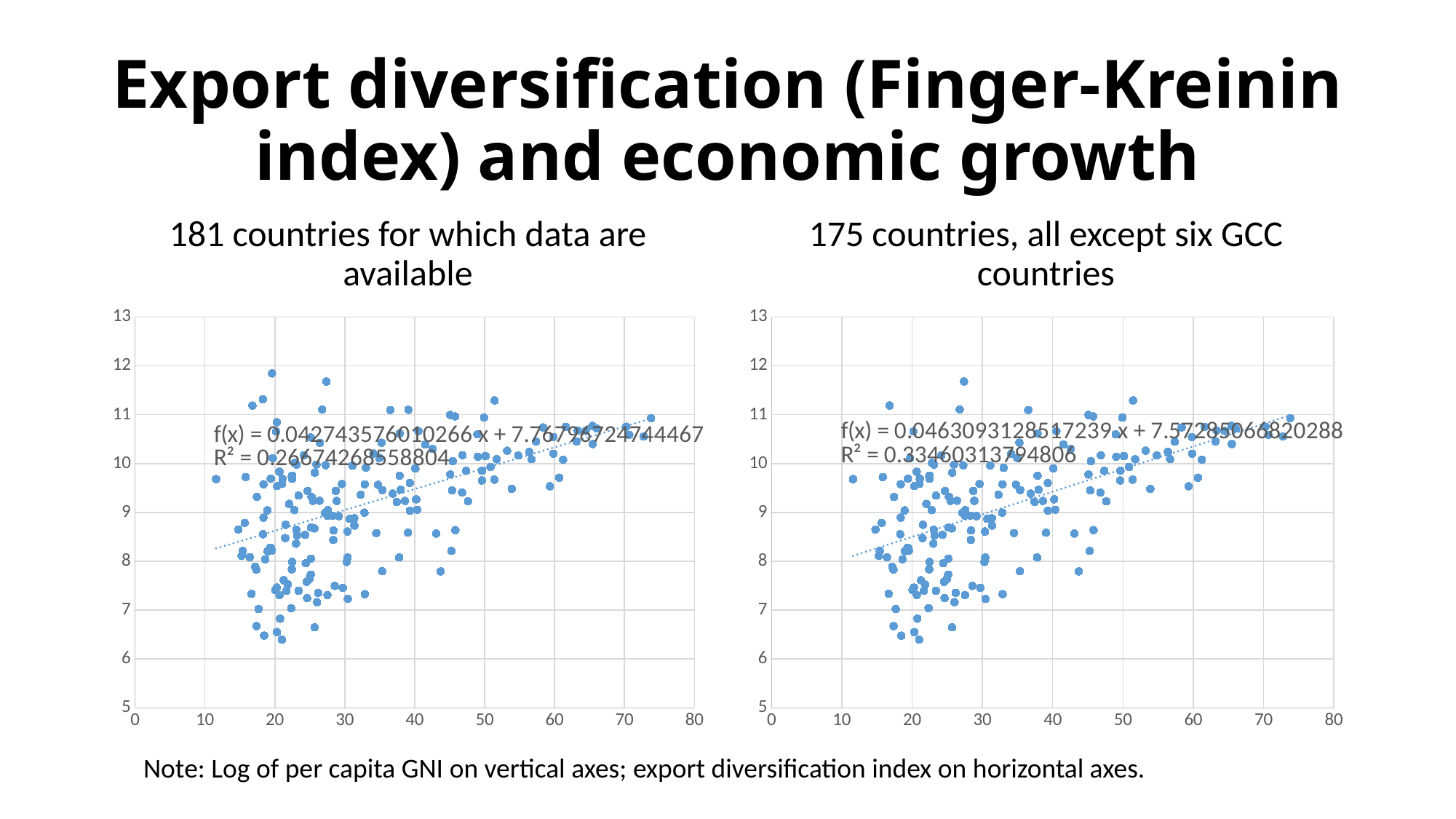
What is the maximum value shown on the horizontal axis of the right chart? 80 How many countries are excluded from the right-hand chart compared with the left-hand chart? 6 In the chart titled '181 countries for which data are available', do the values generally rise or fall as the export diversification index increases? Rise Is the R² value shown on the right chart (175 countries) greater or less than 0.3? greater Which chart has the higher R² value, the left one (181 countries) or the right one (175 countries)? The right one (175 countries) How many countries are included in the right-hand chart? 175 What is the maximum value shown on the vertical axis of the left chart? 13 Is the R² value shown on the left chart (181 countries) greater or less than 0.3? less How many charts are shown on the slide? 2 According to the note, what variable is plotted on the vertical axes? Log of per capita GNI In the chart titled '175 countries, all except six GCC countries', does the trendline slope upward or downward? Upward What kind of chart is shown on the left side of the slide? Scatter plot